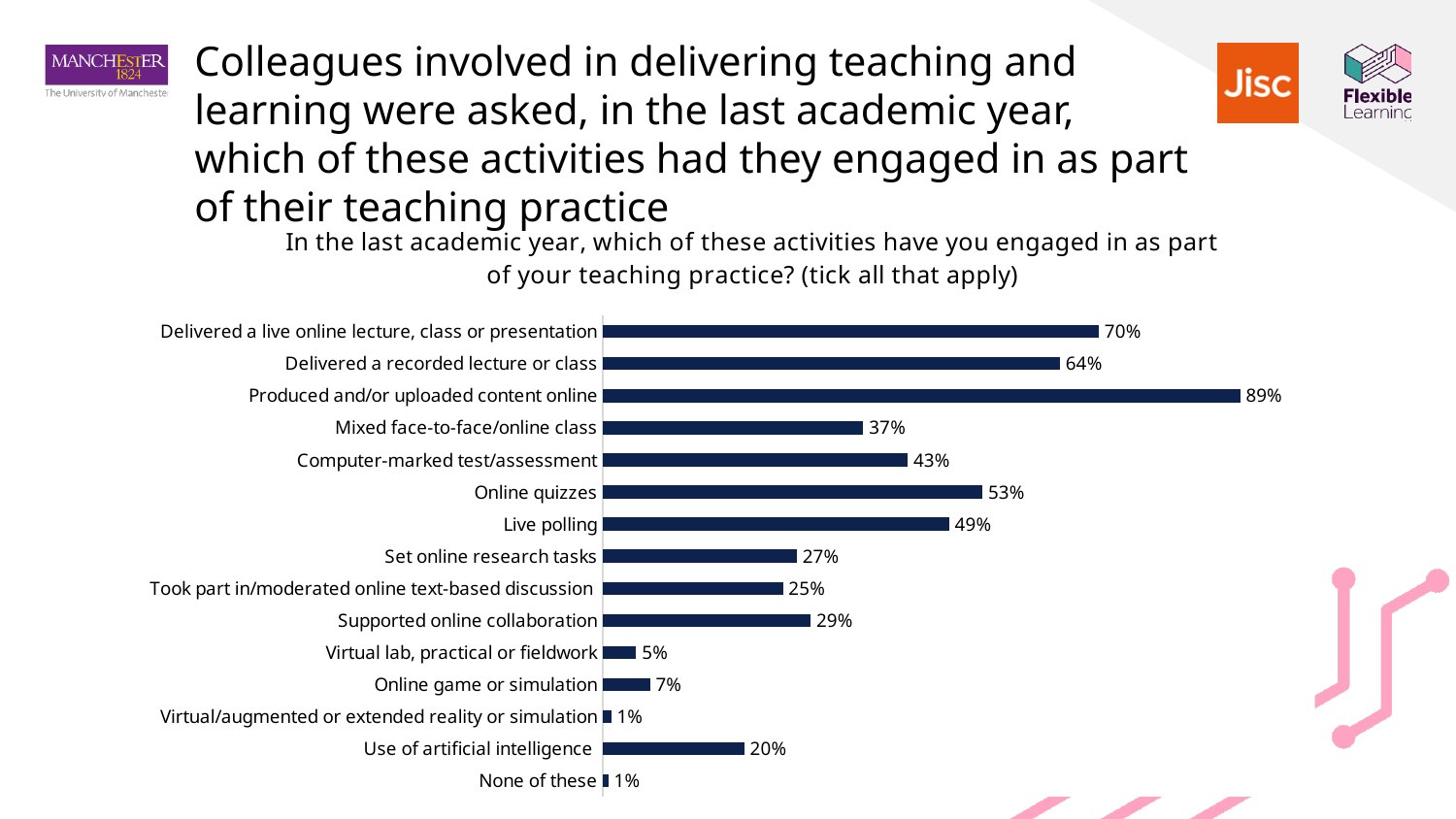
Which activity has the highest percentage in the chart? Produced and/or uploaded content online What is the title of the chart? In the last academic year, which of these activities have you engaged in as part of your teaching practice? (tick all that apply) How many activity categories are shown in the chart? 15 What is the difference between 'Online quizzes' and 'Computer-marked test/assessment'? 10% Which is larger: 'Set online research tasks' or 'Supported online collaboration'? Supported online collaboration What percentage of respondents said they produced and/or uploaded content online? 89% What percentage engaged in live polling? 49% What is the value for 'Virtual lab, practical or fieldwork'? 5% What is the difference between 'Delivered a live online lecture, class or presentation' and 'Delivered a recorded lecture or class'? 6% What is the value shown for 'Use of artificial intelligence'? 20% What type of chart is shown on the slide? Bar chart Which is larger: 'Online game or simulation' or 'Virtual lab, practical or fieldwork'? Online game or simulation